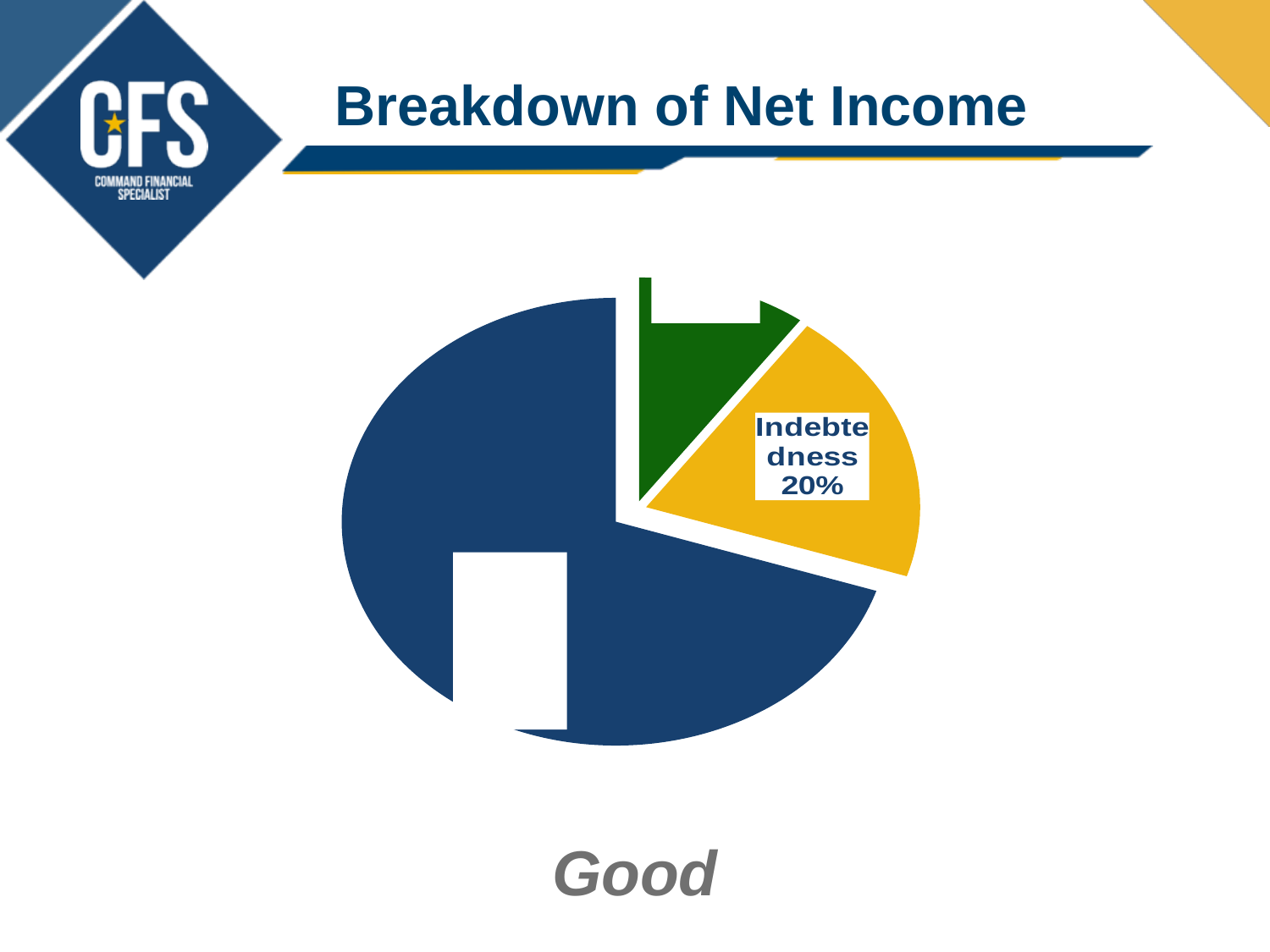
Is the share for Indebtedness greater or less than 50%? less What share of net income does the Indebtedness slice represent? 20% Is the Indebtedness slice the largest slice of the pie? No How many slices does the pie chart have? 3 What kind of chart is shown on the slide? Pie chart Which is larger, the Indebtedness slice or the green slice? Indebtedness What percentage is printed on the Indebtedness slice? 20% What is the title of the chart? Breakdown of Net Income What colour is the largest slice of the pie chart? Dark blue